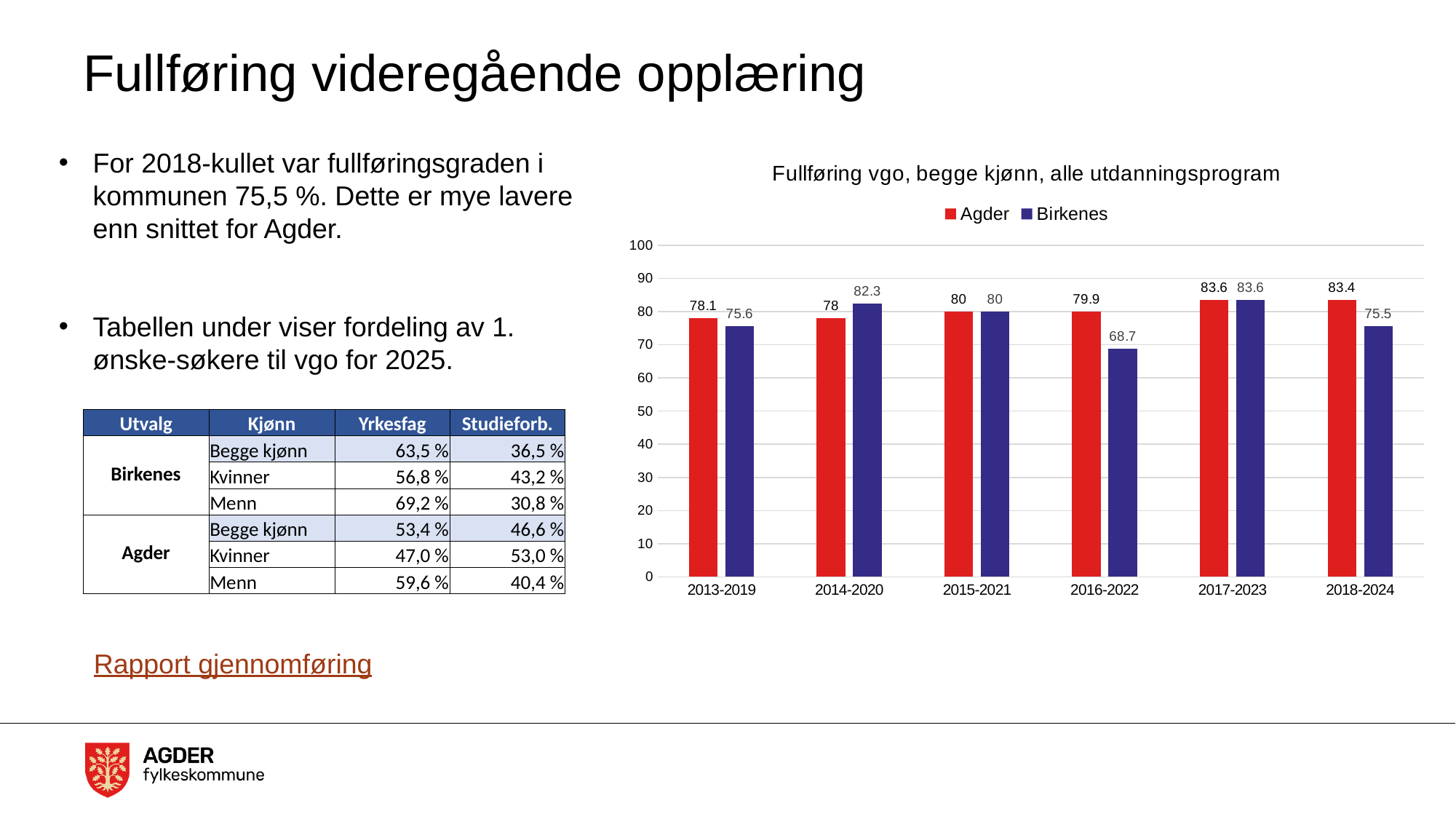
What kind of chart is shown? bar chart In which period is the Birkenes value lowest? 2016-2022 How many periods are shown on the x axis? 6 What is the difference between the Agder and Birkenes values in 2018-2024? 7.9 In which period is the Agder value highest? 2017-2023 What is the value for Birkenes in 2016-2022? 68.7 Is the value for Birkenes in 2016-2022 greater or less than 70? less What is the value for Agder in 2018-2024? 83.4 Which is larger in 2014-2020, Agder or Birkenes? Birkenes How many series does the legend list? 2 What is the title of the chart? Fullføring vgo, begge kjønn, alle utdanningsprogram What is the value for Birkenes in 2014-2020? 82.3